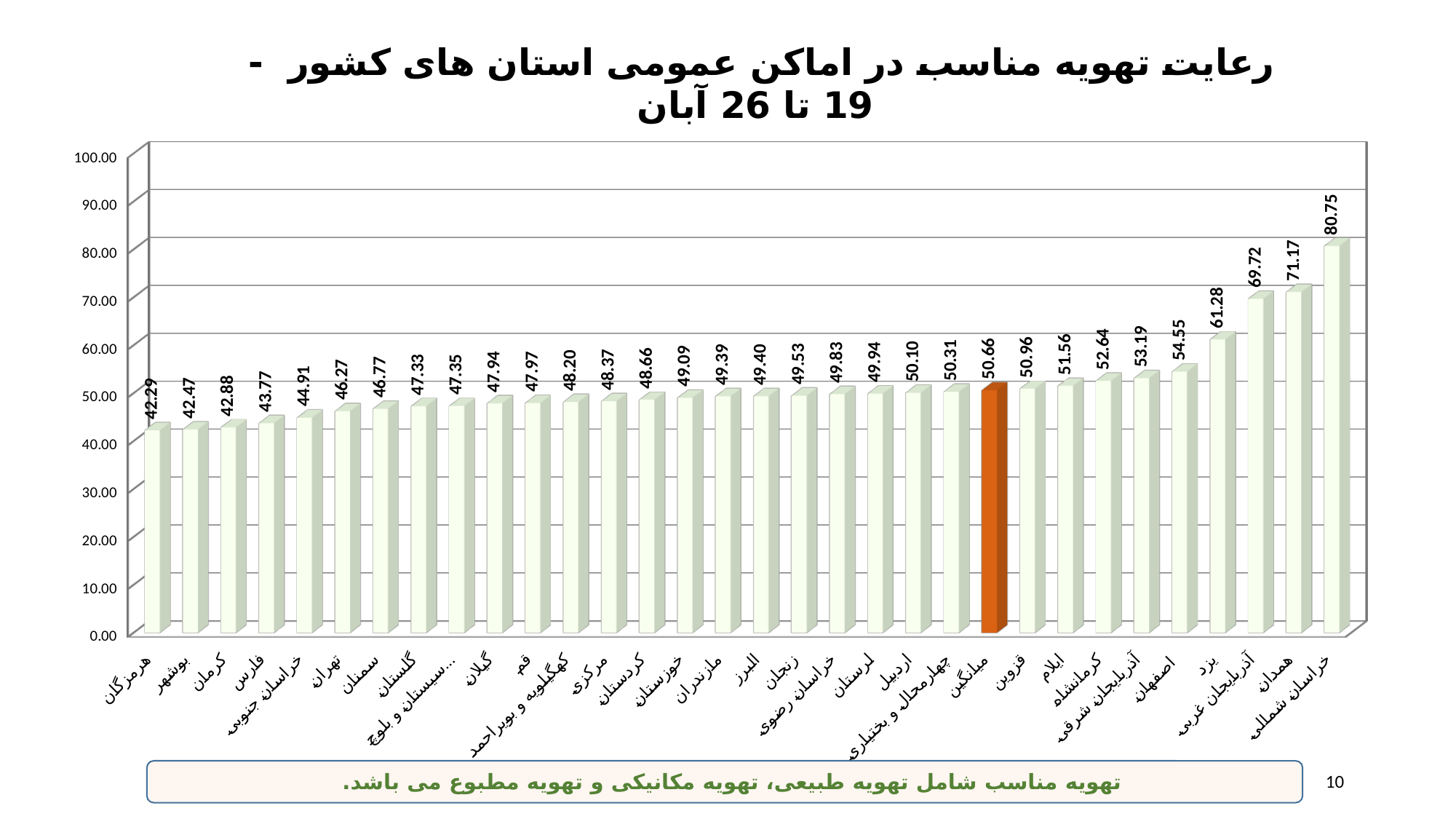
What is the difference between the values for خراسان شمالی and هرمزگان? 38.46 Do the values rise or fall from left to right along the x axis? rise Which is larger, the value for اصفهان or the value for ایلام? اصفهان What is the value of the highlighted میانگین (average) bar? 50.66 What is the value for تهران? 46.27 Which province has the lowest value? هرمزگان Is the value for آذربایجان غربی greater or less than 60.00? greater What is the value for خراسان شمالی? 80.75 Which province has the highest value? خراسان شمالی How many bars are shown in the chart? 32 What kind of chart is shown on the slide? bar chart What is the difference between the values for همدان and یزد? 9.89